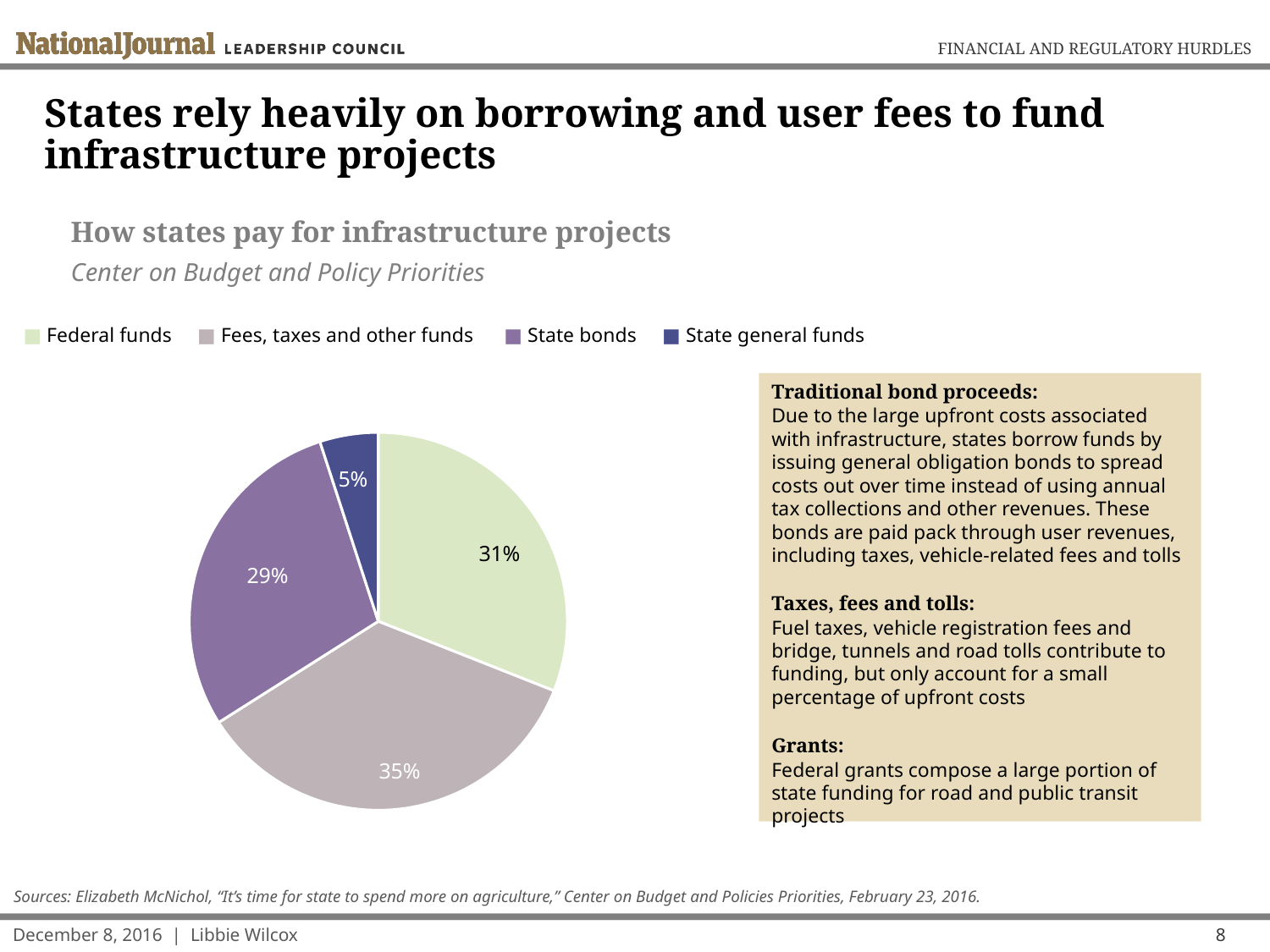
What is the title of the chart? How states pay for infrastructure projects What is the difference in percentage points between Fees, taxes and other funds and State bonds? 6 What kind of chart is shown on the slide? Pie chart Which funding source has the smallest share of the pie? State general funds Which is larger, the share for Federal funds or the share for State bonds? Federal funds Which funding source has the largest share of the pie? Fees, taxes and other funds What share of the pie does Federal funds account for? 31% What share of the pie does State general funds account for? 5% What is the difference in percentage points between Federal funds and State general funds? 26 What share of the pie does State bonds account for? 29% How many slices does the pie chart have? 4 What share of the pie does Fees, taxes and other funds account for? 35%